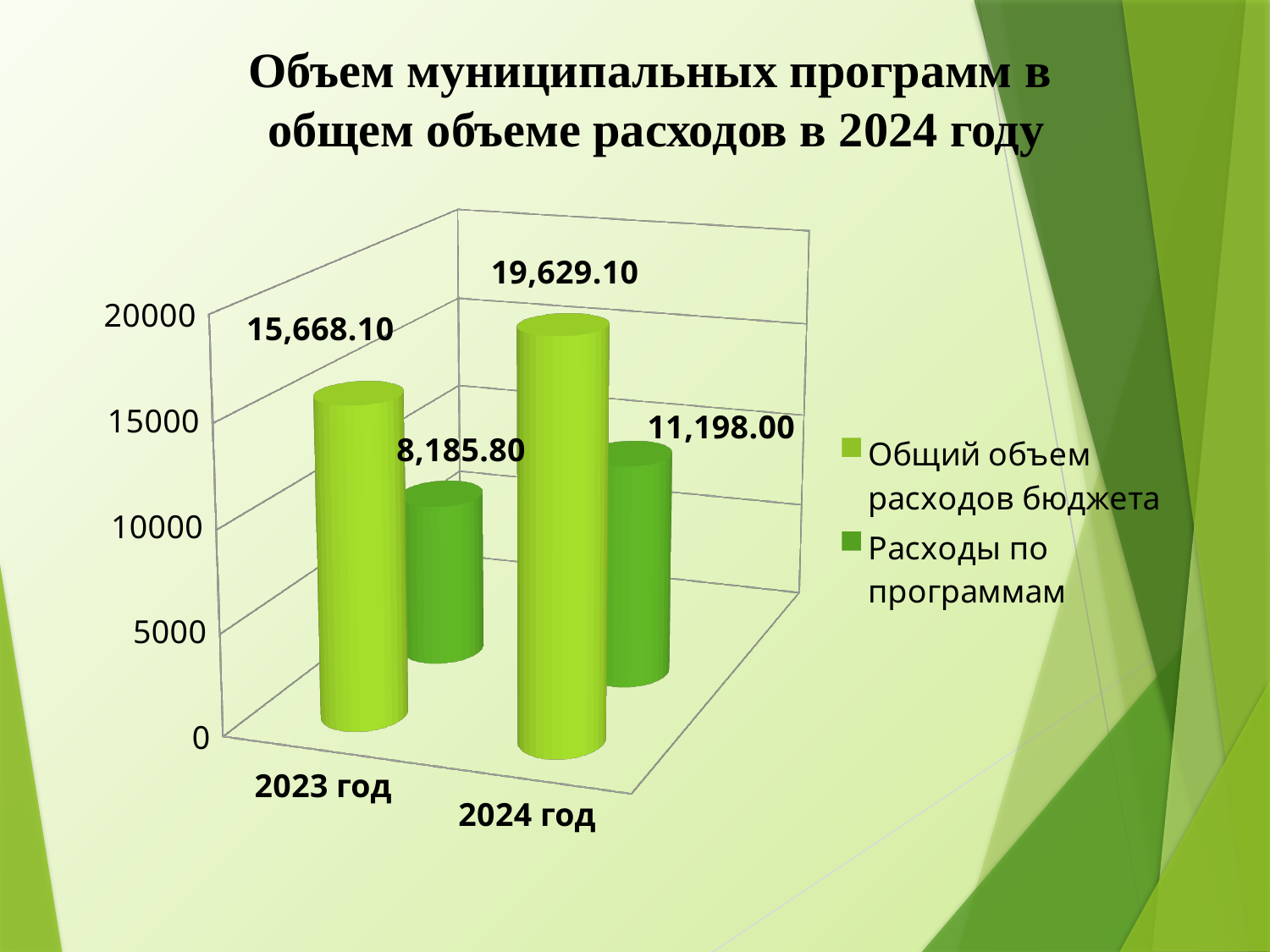
What is the value of Расходы по программам for 2024 год? 11,198.00 Does Расходы по программам rise or fall from 2023 год to 2024 год? rise What is the difference between Общий объем расходов бюджета and Расходы по программам in 2024 год? 8,431.10 By how much does Общий объем расходов бюджета in 2024 год exceed that in 2023 год? 3,961.00 Which year has the lower value for Расходы по программам? 2023 год Which year has the higher value for Общий объем расходов бюджета? 2024 год How many series does the legend list? 2 Which is larger in 2023 год: Общий объем расходов бюджета or Расходы по программам? Общий объем расходов бюджета What is the value of Общий объем расходов бюджета for 2024 год? 19,629.10 What kind of chart is shown on the slide? bar chart What is the value of Расходы по программам for 2023 год? 8,185.80 What is the value of Общий объем расходов бюджета for 2023 год? 15,668.10